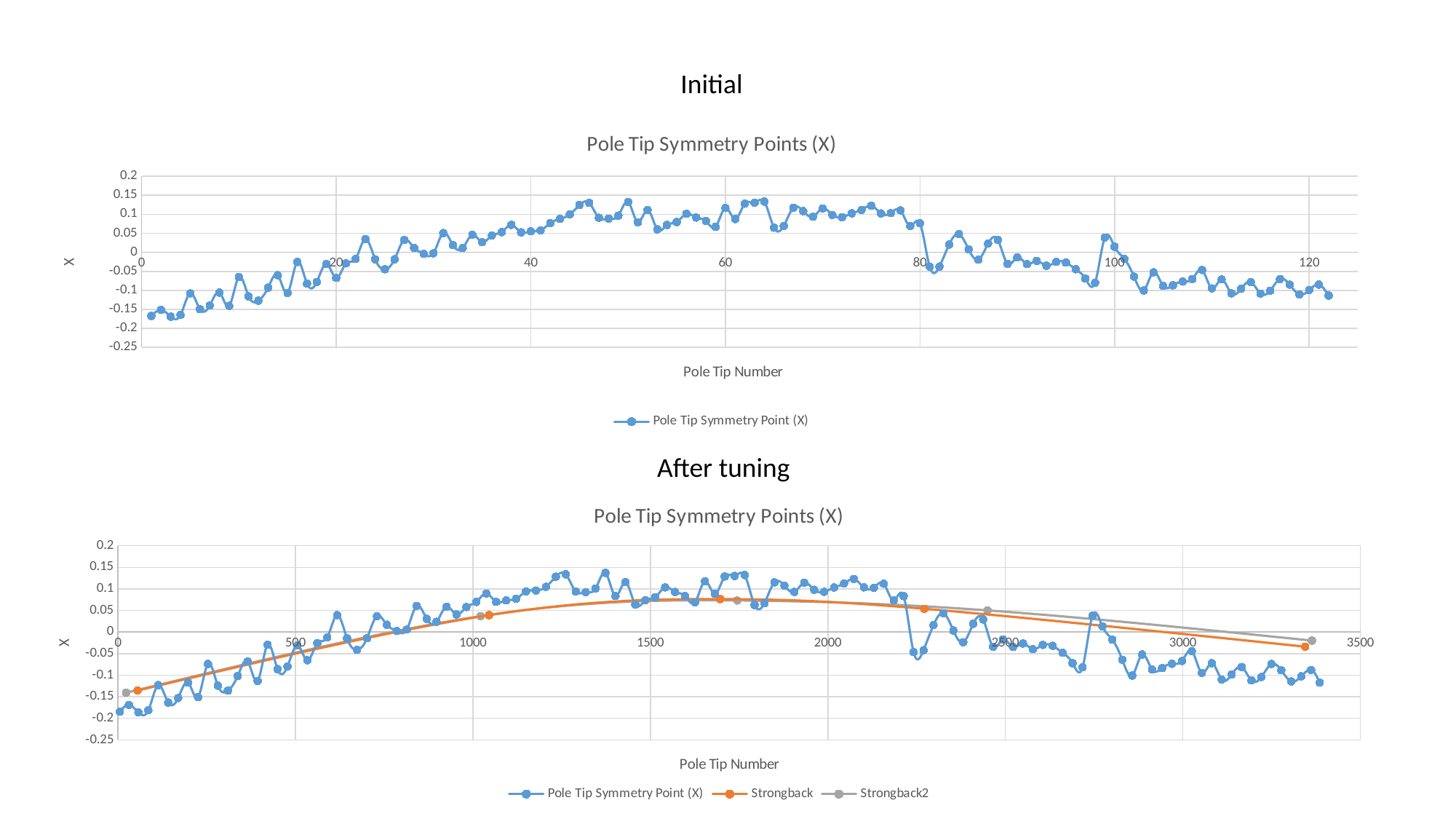
What kind of chart is the top chart titled "Initial"? Line chart In the bottom chart ("After tuning"), is the Strongback value at x = 0 greater or less than -0.1? less In the top chart ("Initial"), which is larger: the value at pole tip number 0 or the value at pole tip number 46? Pole tip number 46 In the top chart ("Initial"), is the value at pole tip number 0 greater or less than -0.1? less How many series does the legend of the top chart ("Initial") list? 1 In the top chart ("Initial"), do the values generally rise or fall between pole tip number 80 and pole tip number 120? fall What is the x-axis label of the top chart ("Initial")? Pole Tip Number In the top chart ("Initial"), is the value at pole tip number 60 greater or less than 0? greater How many series does the legend of the bottom chart ("After tuning") list? 3 In the top chart ("Initial"), do the values generally rise or fall between pole tip number 0 and pole tip number 40? rise In the bottom chart ("After tuning"), what are the names of the three series in the legend? Pole Tip Symmetry Point (X), Strongback, Strongback2 In the bottom chart ("After tuning"), at the right end of the lines near x = 3500, which series is higher: Strongback or Strongback2? Strongback2